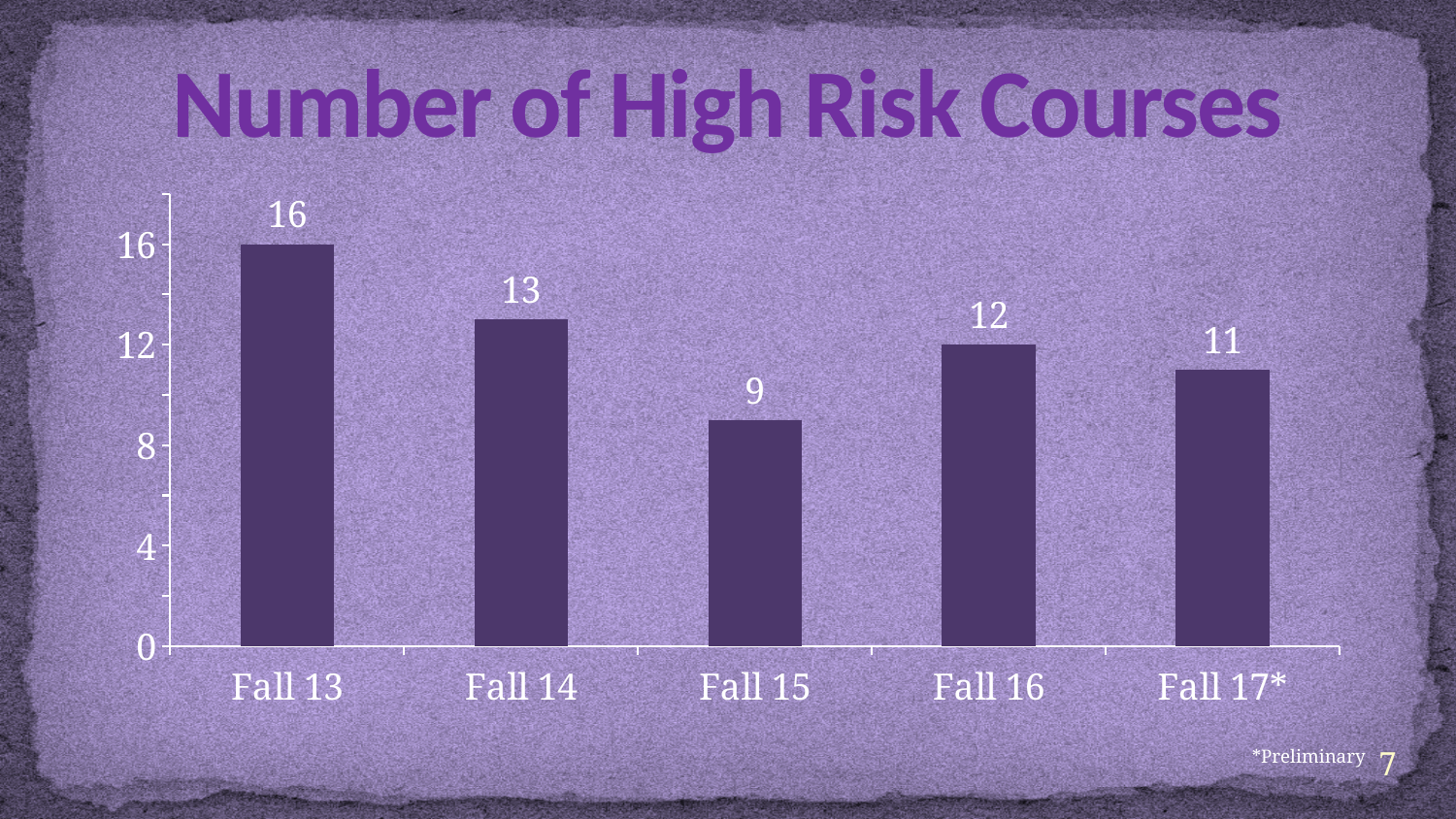
What is the number of high risk courses for Fall 15? 9 What is the title of the chart? Number of High Risk Courses Which term has the highest number of high risk courses? Fall 13 Which term has the lowest number of high risk courses? Fall 15 What is the number of high risk courses for Fall 17*? 11 How many terms are shown on the chart? 5 What is the difference between the number of high risk courses in Fall 13 and Fall 15? 7 Is the value for Fall 15 greater or less than 12? less Which has more high risk courses, Fall 14 or Fall 16? Fall 14 What is the number of high risk courses for Fall 13? 16 What kind of chart is shown on the slide? Bar chart What is the difference between the number of high risk courses in Fall 16 and Fall 17*? 1